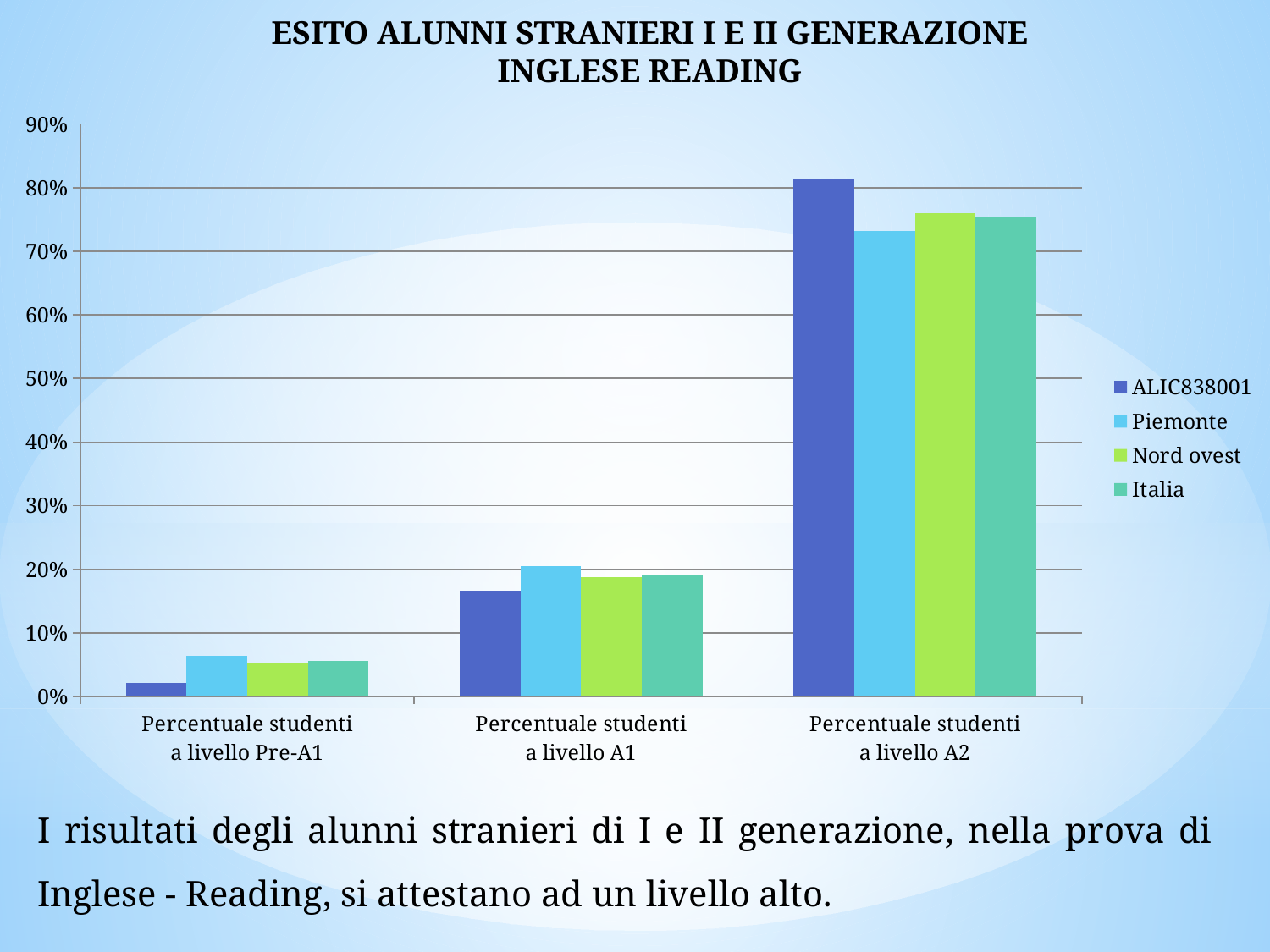
Is the value for ALIC838001 at 'Percentuale studenti a livello A2' greater or less than 80%? greater Do the values for ALIC838001 rise or fall from Pre-A1 to A2 along the x axis? rise How many series does the legend list? 4 Is the value for Piemonte at 'Percentuale studenti a livello A2' greater or less than 70%? greater Which series has the lowest value for 'Percentuale studenti a livello Pre-A1'? ALIC838001 At 'Percentuale studenti a livello A1', which is larger: Piemonte or ALIC838001? Piemonte At 'Percentuale studenti a livello A2', which is larger: ALIC838001 or Piemonte? ALIC838001 How many categories are shown on the x axis? 3 Is the value for Piemonte at 'Percentuale studenti a livello Pre-A1' greater or less than 10%? less Which series has the highest value for 'Percentuale studenti a livello A2'? ALIC838001 What kind of chart is shown on the slide? bar chart